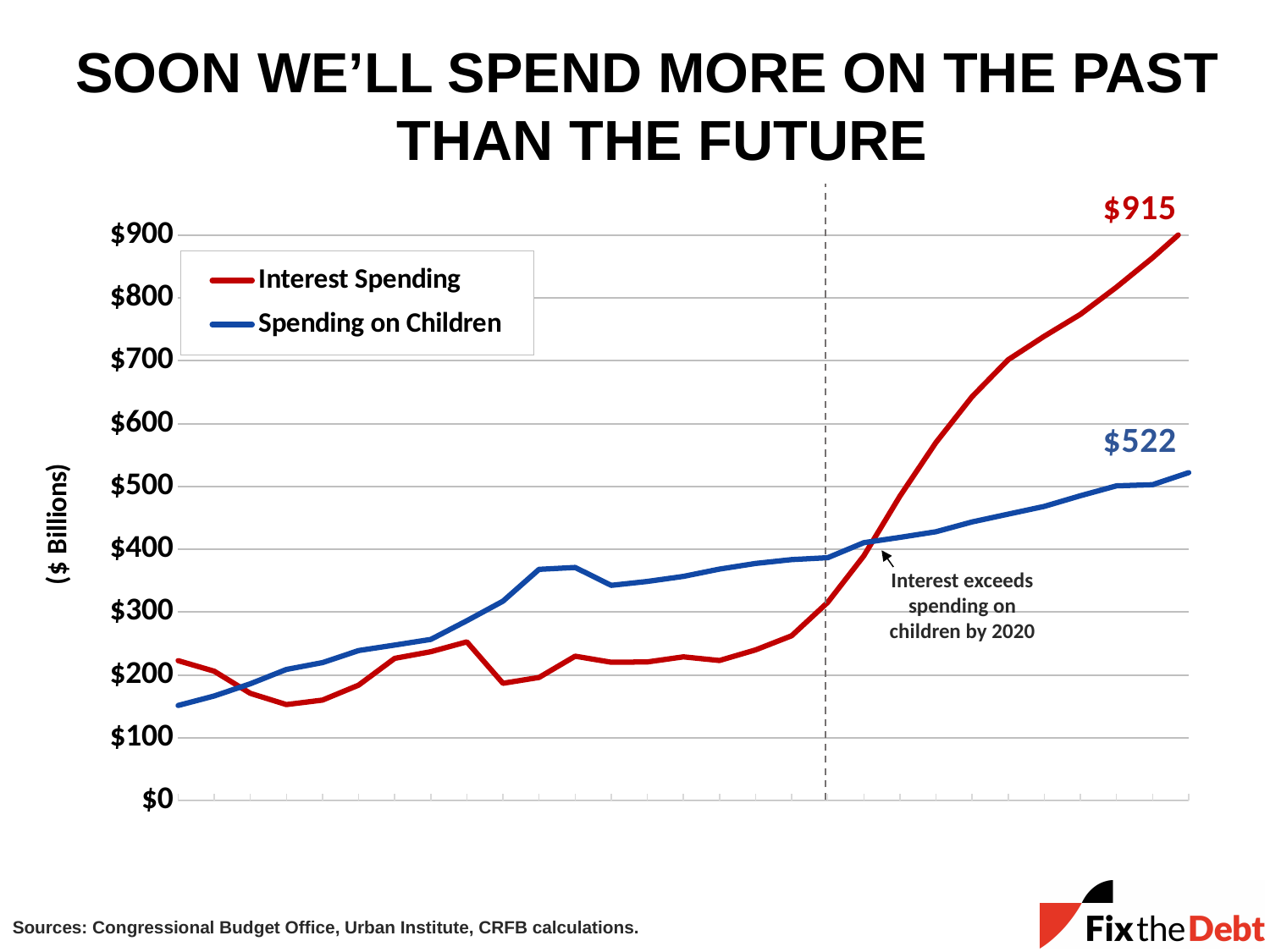
Which series reaches the highest value on the chart? Interest Spending What is the final labelled value of the Spending on Children line? $522 How many series does the legend list? 2 According to the annotation, by what year does interest exceed spending on children? 2020 What is the final labelled value of the Interest Spending line? $915 What kind of chart is shown on the slide? line chart What is the label on the vertical axis? ($ Billions) Is the starting value of the Spending on Children line greater or less than $200? less What is the difference between the final labelled values of Interest Spending ($915) and Spending on Children ($522)? $393 Does the Spending on Children line rise or fall overall from left to right? rise At the right end of the chart, which series has the larger value, Interest Spending or Spending on Children? Interest Spending Is the final value for Interest Spending greater or less than $900? greater